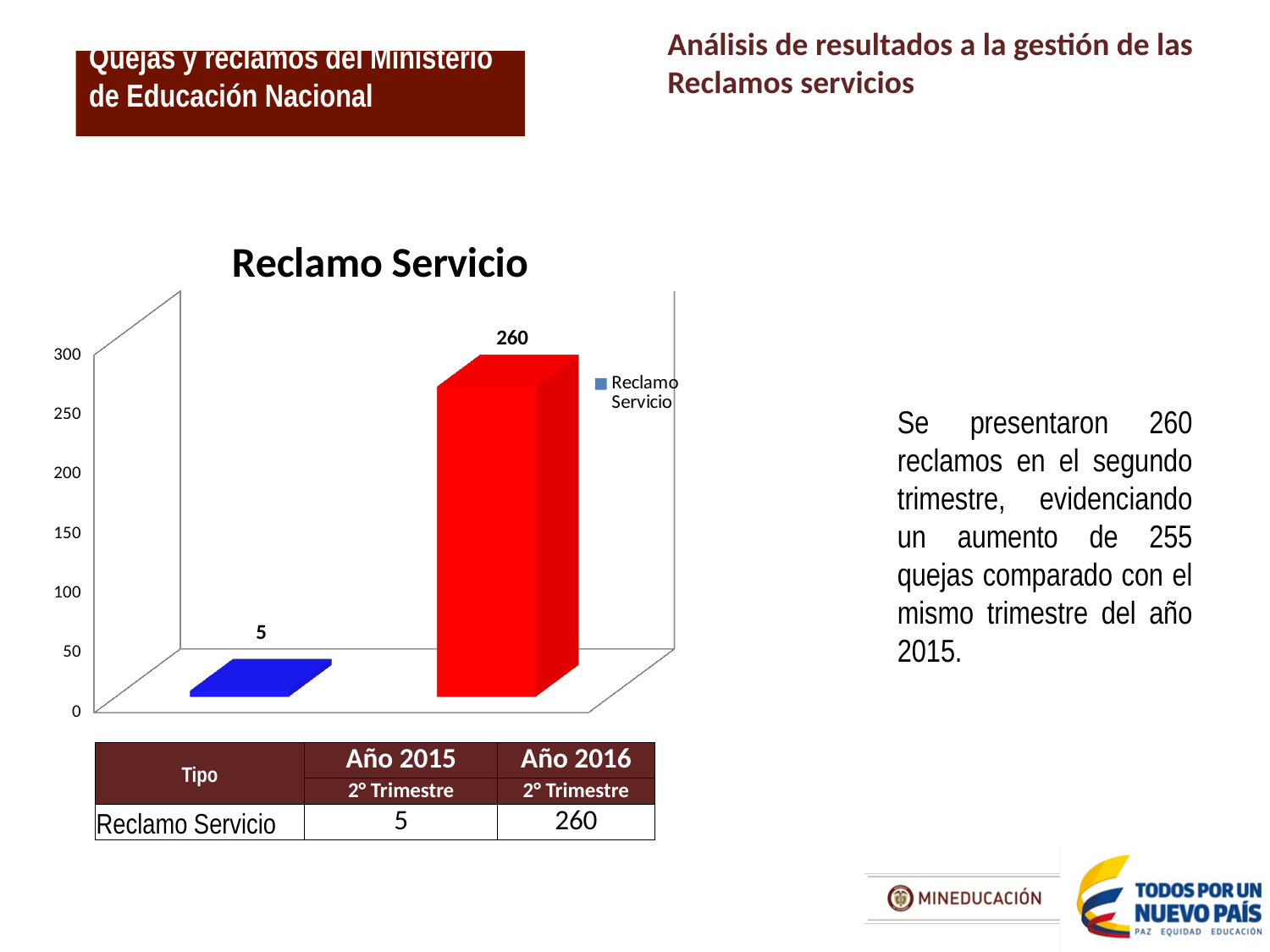
Which bar in the Reclamo Servicio chart has the lowest value, the left blue bar or the right red bar? the left blue bar What is the difference between the two bar values in the Reclamo Servicio chart? 255 What is the value shown on the left (blue) bar in the Reclamo Servicio chart? 5 How many entries does the legend of the Reclamo Servicio chart list? 1 Is the value of the blue bar in the Reclamo Servicio chart greater or less than 50? less What is the value shown on the right (red) bar in the Reclamo Servicio chart? 260 Is the value of the red bar in the Reclamo Servicio chart greater or less than 250? greater How many bars are plotted in the Reclamo Servicio chart? 2 What type of chart is the Reclamo Servicio chart? bar chart In the Reclamo Servicio chart, is the red bar's value larger or smaller than the blue bar's value? larger What is the title of the chart on the slide? Reclamo Servicio Which bar in the Reclamo Servicio chart has the highest value, the left blue bar or the right red bar? the right red bar